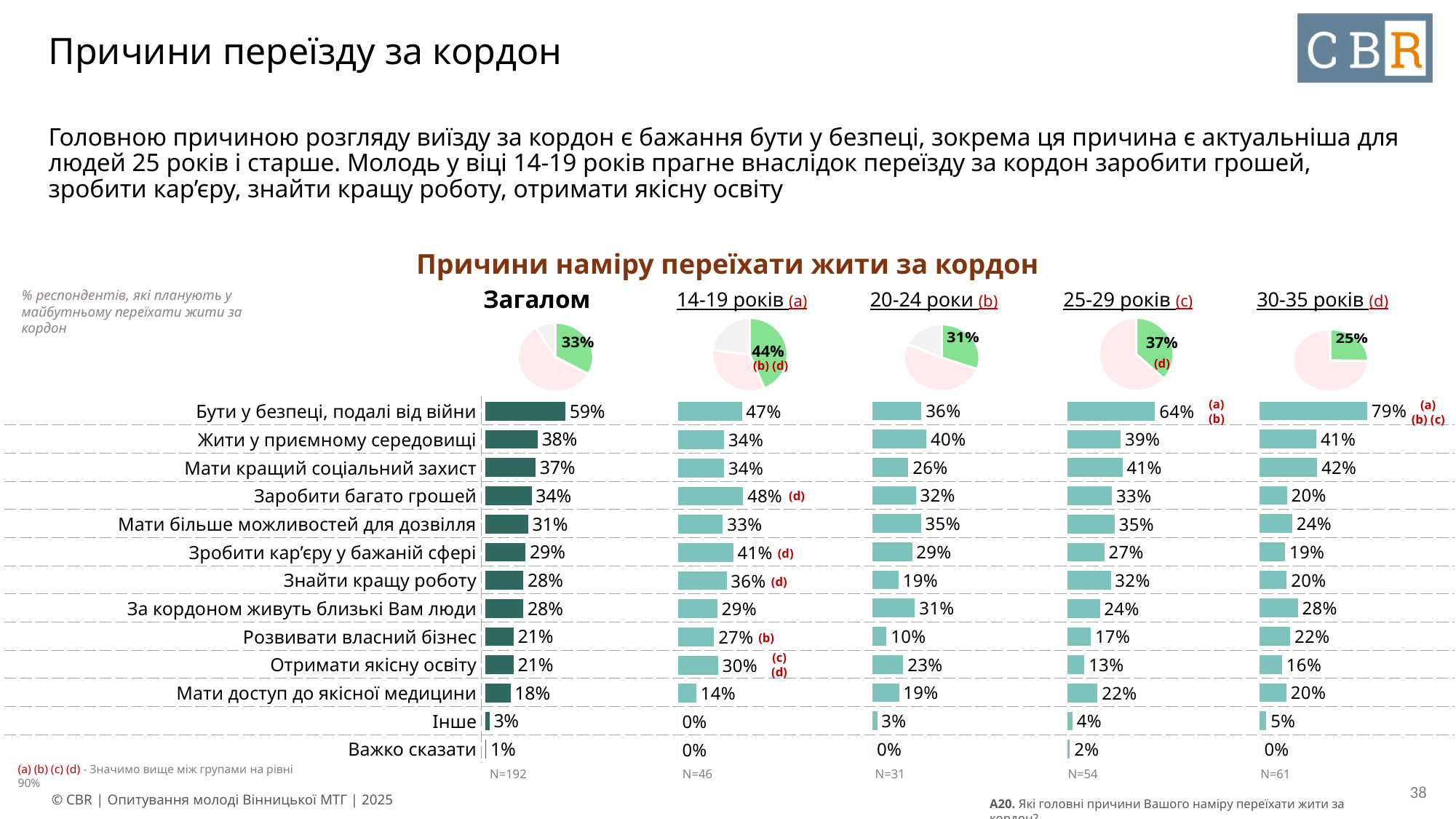
In the '25-29 років' bar chart, what is the difference between 'Бути у безпеці, подалі від війни' and 'Мати кращий соціальний захист'? 23% In the pie chart above the '14-19 років' column, what share is shown in green? 44% In the '30-35 років' bar chart, which category has the highest value? Бути у безпеці, подалі від війни In the '20-24 роки' bar chart, what is the value for 'Розвивати власний бізнес'? 10% In the '20-24 роки' bar chart, which category has the highest value? Жити у приємному середовищі In the pie chart above the '30-35 років' column, what share is shown in green? 25% What is the title of the chart section on the slide? Причини наміру переїхати жити за кордон In the '14-19 років' bar chart, what is the value for 'Заробити багато грошей'? 48% What kind of chart is used for the 'Загалом' column? Bar chart How many categories are listed in the 'Загалом' bar chart? 13 In the 'Загалом' bar chart, what is the value for 'Бути у безпеці, подалі від війни'? 59% Which is larger: 'Отримати якісну освіту' in the '14-19 років' chart or in the '25-29 років' chart? 14-19 років